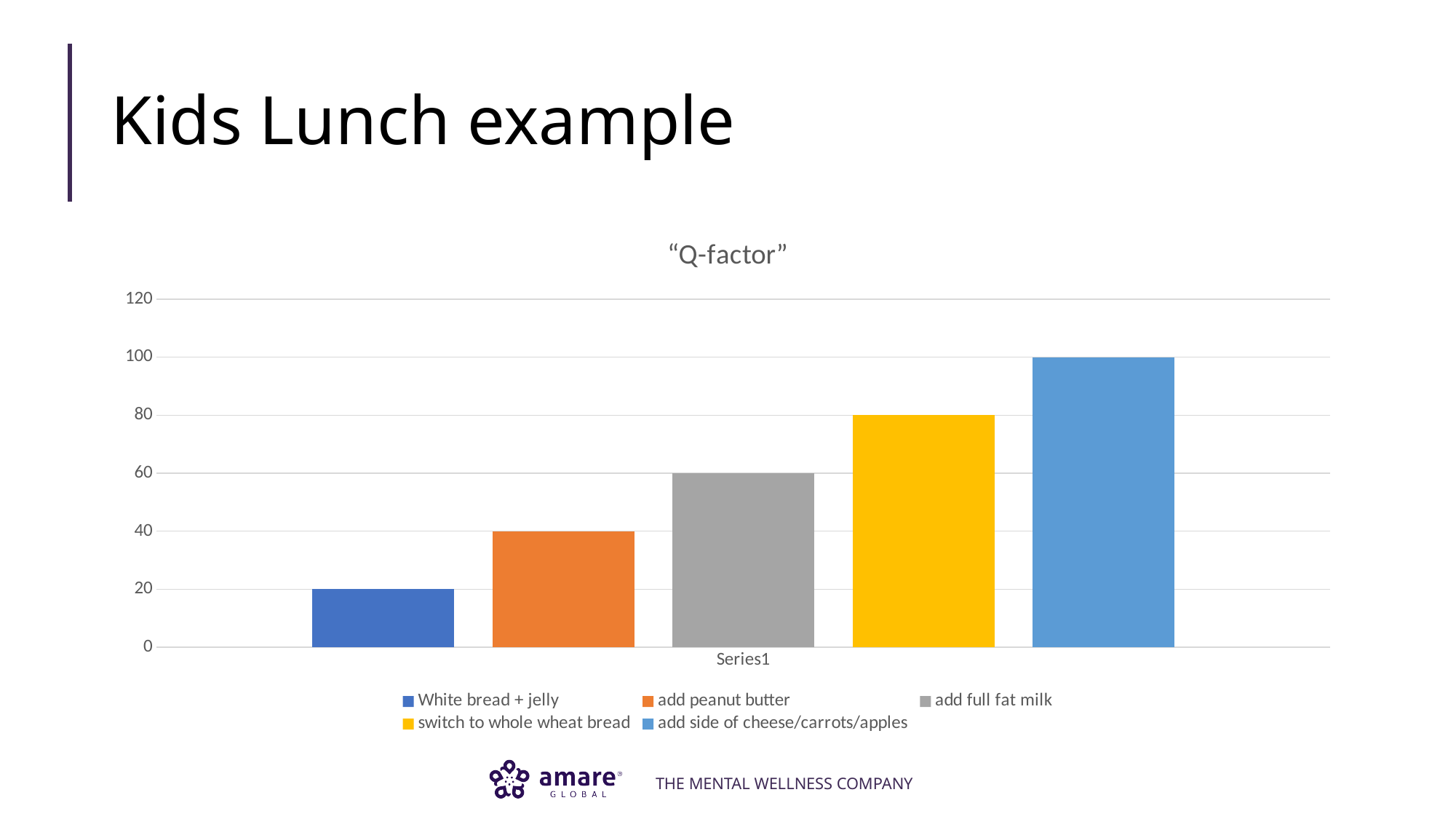
Which legend entry has the highest value? add side of cheese/carrots/apples What kind of chart is shown on the slide? bar chart How many entries does the chart legend list? 5 What is the title of the chart? "Q-factor" What is the value for "add full fat milk"? 60 What is the value for "add peanut butter"? 40 Which legend entry has the lowest value? White bread + jelly What is the value for "White bread + jelly"? 20 What is the difference between the values for "add side of cheese/carrots/apples" and "White bread + jelly"? 80 What is the value for "switch to whole wheat bread"? 80 Do the bar values rise or fall from left to right across the chart? rise What is the value for "add side of cheese/carrots/apples"? 100